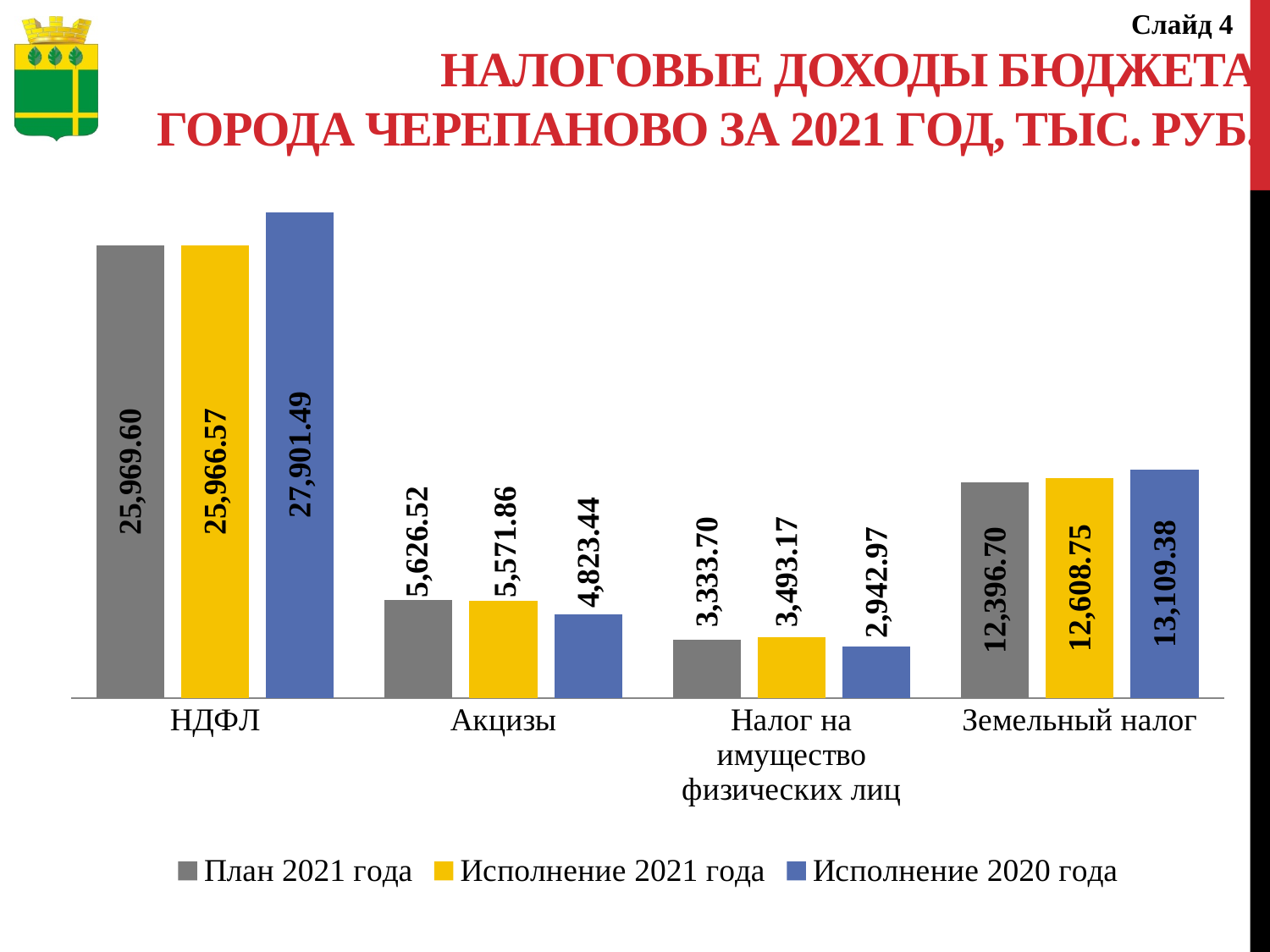
What is the value for НДФЛ in the Исполнение 2020 года series? 27,901.49 Which category has the highest value in the Исполнение 2021 года series? НДФЛ What is the value for Налог на имущество физических лиц in the Исполнение 2021 года series? 3,493.17 For Земельный налог, which is larger: Исполнение 2020 года or План 2021 года? Исполнение 2020 года How many categories are shown on the x axis? 4 What is the difference between Исполнение 2021 года and План 2021 года for Земельный налог? 212.05 What is the value for Земельный налог in the Исполнение 2020 года series? 13,109.38 How many series does the legend list? 3 Which category has the lowest value in the Исполнение 2020 года series? Налог на имущество физических лиц What is the difference between План 2021 года and Исполнение 2020 года for Акцизы? 803.08 What is the value for Акцизы in the План 2021 года series? 5,626.52 What kind of chart is shown on the slide? Bar chart